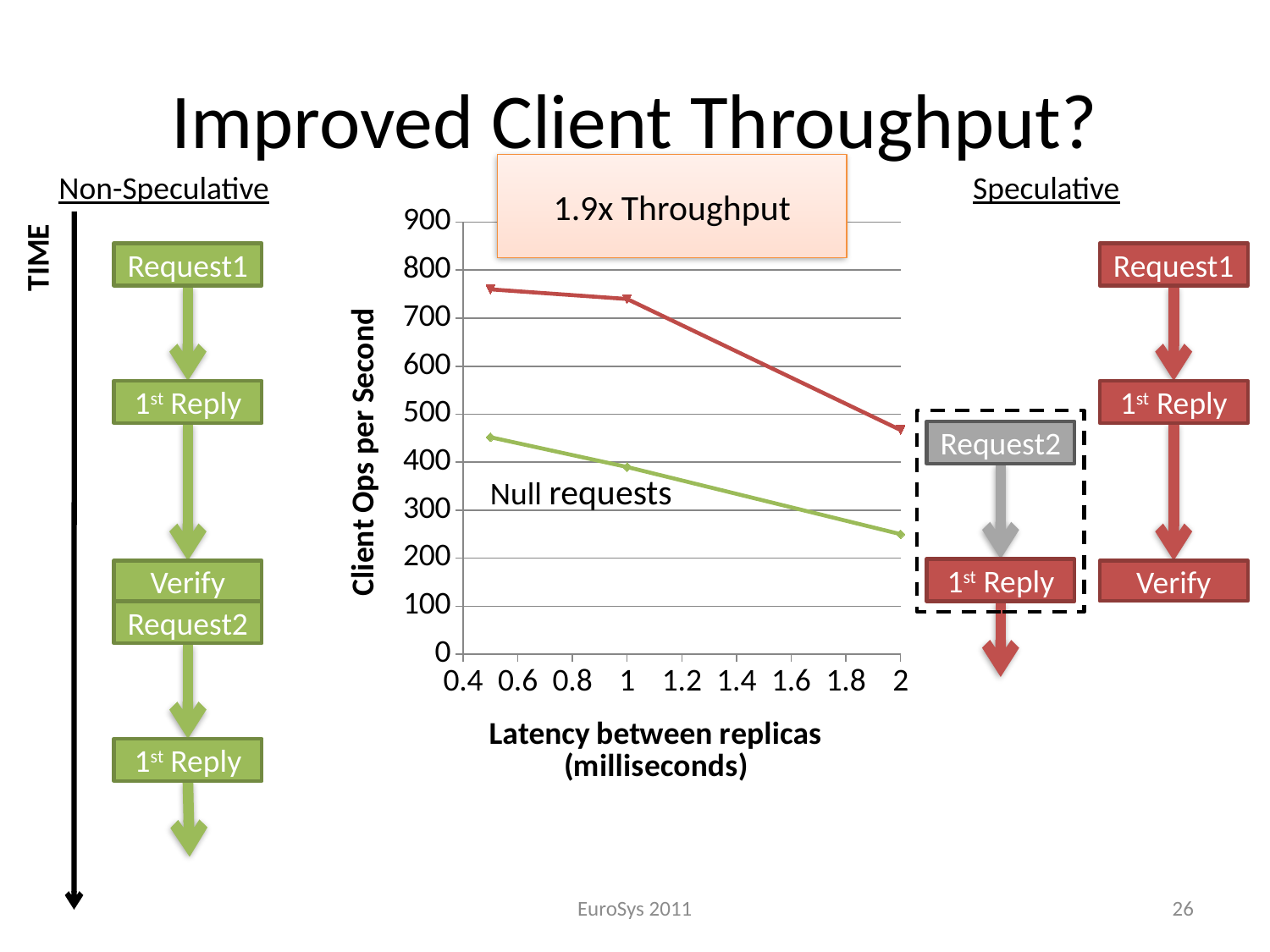
How many lines are plotted on the chart? 2 What is the highest value shown on the y-axis of the chart? 900 Is the value of the green 'Null requests' line at a latency of 2 milliseconds greater or less than 300? less What kind of chart is shown in the middle of the slide? line chart Do the values of the green 'Null requests' line rise or fall as latency between replicas increases? fall Do the values of the red line rise or fall as latency between replicas increases? fall What is the y-axis title of the chart? Client Ops per Second At a latency of 1 millisecond, which line has the higher value, the red line or the green 'Null requests' line? the red line What is the x-axis title of the chart? Latency between replicas (milliseconds) Is the value of the red line at a latency of 1 millisecond greater or less than 700? greater How many data points does the green 'Null requests' line have? 3 Is the value of the red line at a latency of 2 milliseconds greater or less than 400? greater